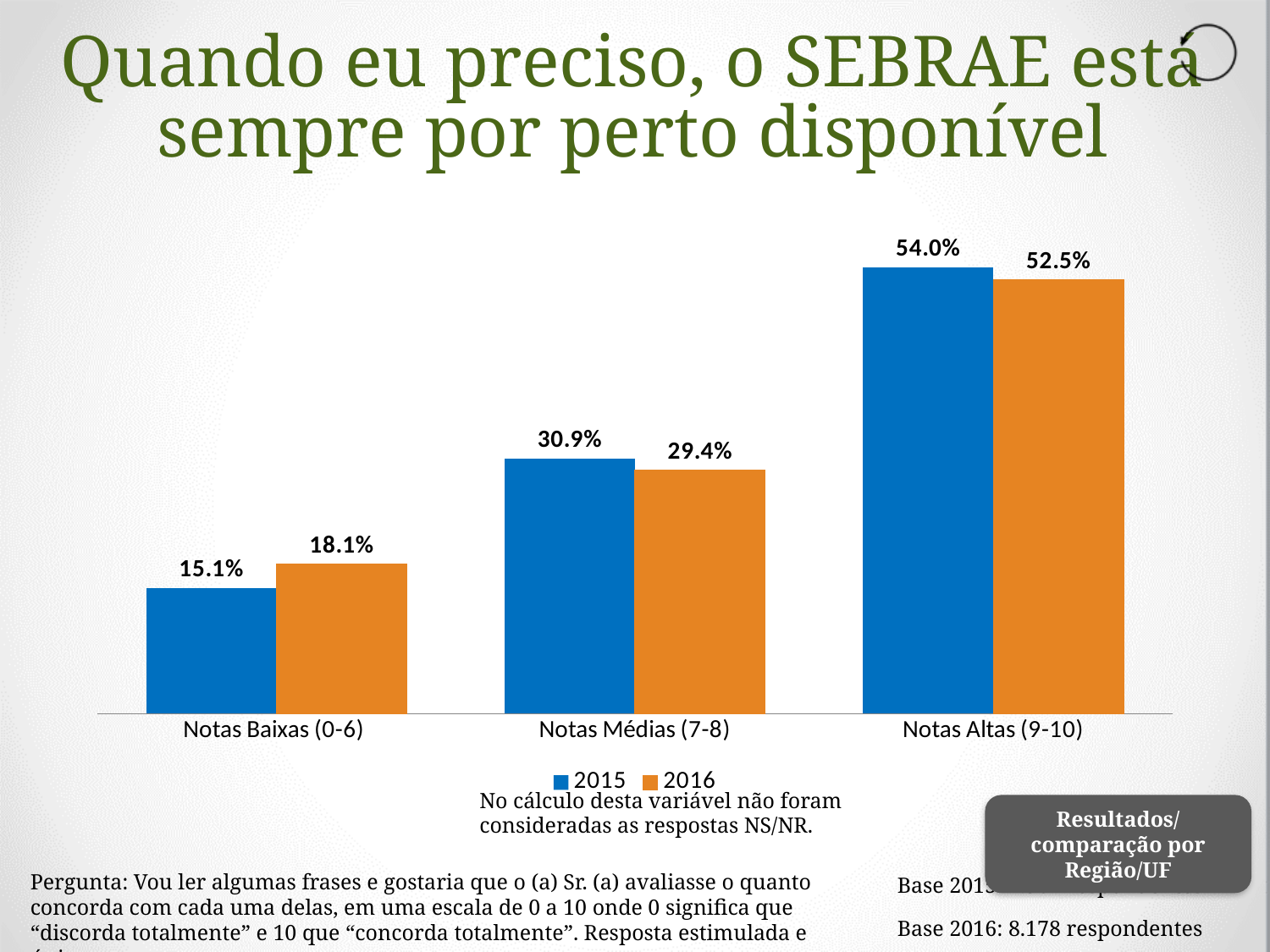
What is the difference between the 2015 and 2016 values for Notas Baixas (0-6)? 3.0% What kind of chart is shown on the slide? Bar chart What is the value for Notas Altas (9-10) in 2016? 52.5% Which category has the highest value for 2015? Notas Altas (9-10) What is the difference between the 2015 and 2016 values for Notas Altas (9-10)? 1.5% What is the value for Notas Médias (7-8) in 2016? 29.4% What is the value for Notas Baixas (0-6) in 2015? 15.1% How many categories are shown on the x axis? 3 Which colour represents the 2016 series in the legend? Orange How many series does the legend list? 2 Which category has the lowest value for 2016? Notas Baixas (0-6) Which is larger for Notas Médias (7-8): the 2015 value or the 2016 value? 2015